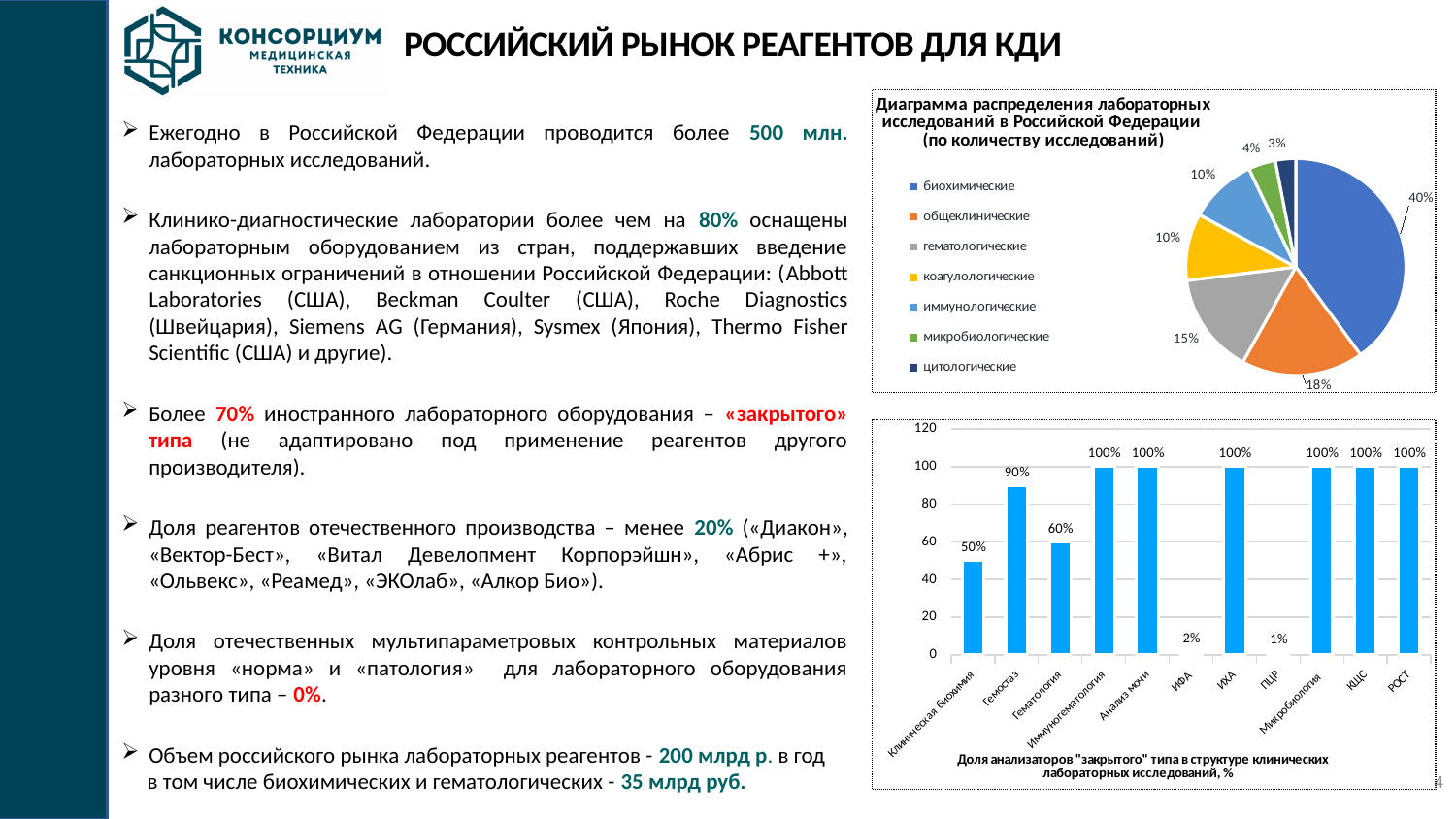
In the bar chart 'Доля анализаторов "закрытого" типа в структуре клинических лабораторных исследований, %', what is the difference between the values for Гемостаз and Гематология? 30% What kind of chart is the lower chart on the right side of the slide? bar chart In the bar chart 'Доля анализаторов "закрытого" типа в структуре клинических лабораторных исследований, %', which category has the lowest value? ПЦР In the pie chart 'Диаграмма распределения лабораторных исследований в Российской Федерации', what share do биохимические studies have? 40% In the pie chart 'Диаграмма распределения лабораторных исследований в Российской Федерации', what share do общеклинические studies have? 18% In the pie chart 'Диаграмма распределения лабораторных исследований в Российской Федерации', what is the difference between the shares of биохимические and гематологические studies? 25% In the pie chart 'Диаграмма распределения лабораторных исследований в Российской Федерации', how many categories does the legend list? 7 In the pie chart 'Диаграмма распределения лабораторных исследований в Российской Федерации', which category has the smallest share? цитологические In the bar chart 'Доля анализаторов "закрытого" типа в структуре клинических лабораторных исследований, %', how many categories are shown on the x axis? 11 In the bar chart 'Доля анализаторов "закрытого" типа в структуре клинических лабораторных исследований, %', which is larger: the value for Гематология or the value for ИФА? Гематология In the bar chart 'Доля анализаторов "закрытого" типа в структуре клинических лабораторных исследований, %', what is the value for Гемостаз? 90% In the bar chart 'Доля анализаторов "закрытого" типа в структуре клинических лабораторных исследований, %', what is the value for Клиническая биохимия? 50%